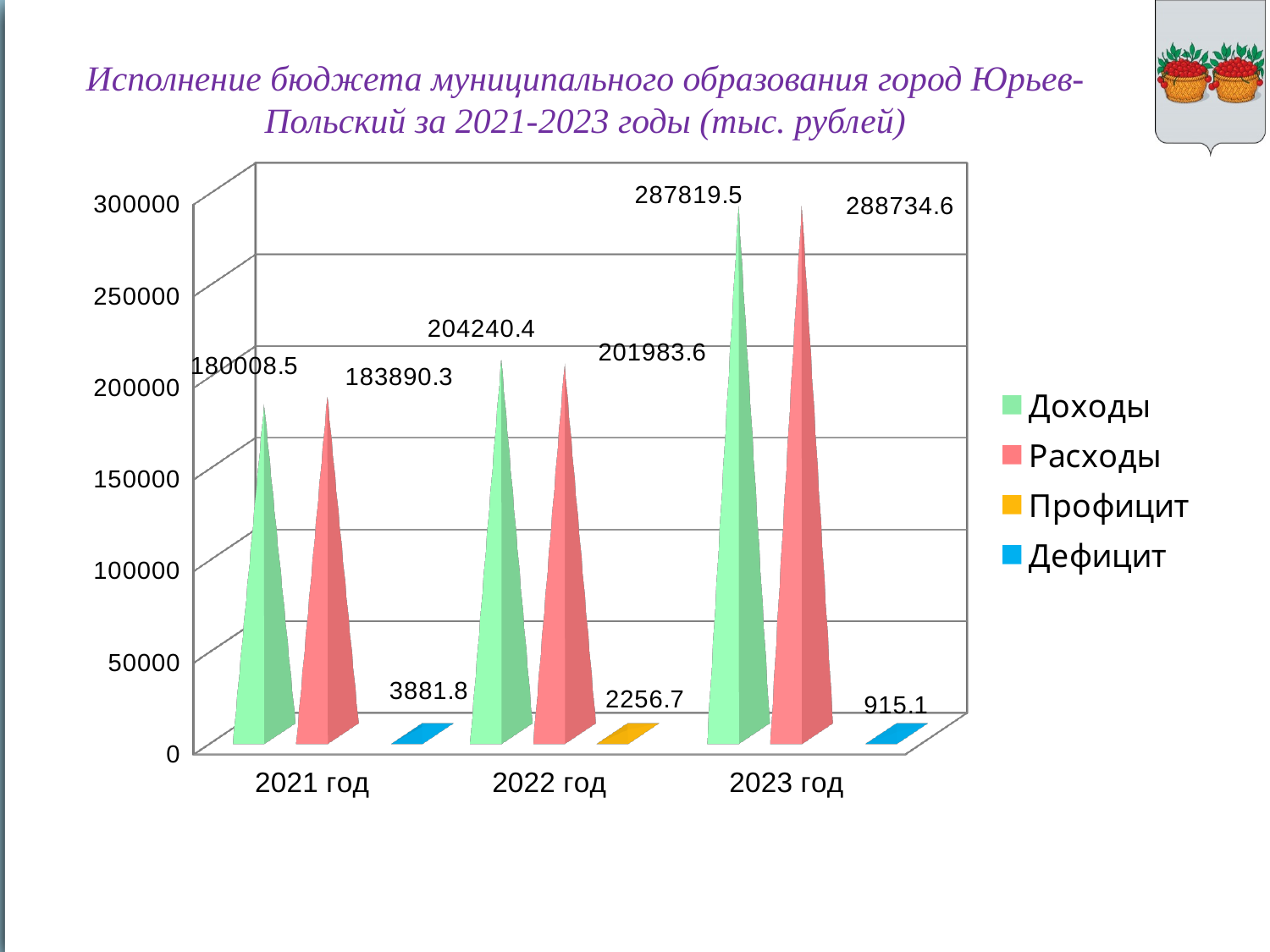
By how much did Доходы increase from 2021 год to 2023 год? 107811.0 What is the difference between Расходы and Доходы in 2021 год? 3881.8 How many series does the legend list? 4 What is the value of Расходы for 2023 год? 288734.6 What is the value of Дефицит for 2023 год? 915.1 In 2022 год, which is larger: Доходы or Расходы? Доходы What is the value of Доходы for 2021 год? 180008.5 What kind of chart is shown on the slide? Bar chart What is the value of Профицит for 2022 год? 2256.7 In which year is Расходы the lowest? 2021 год In which year is Доходы the highest? 2023 год Do the Доходы values rise or fall from 2021 год to 2023 год? Rise